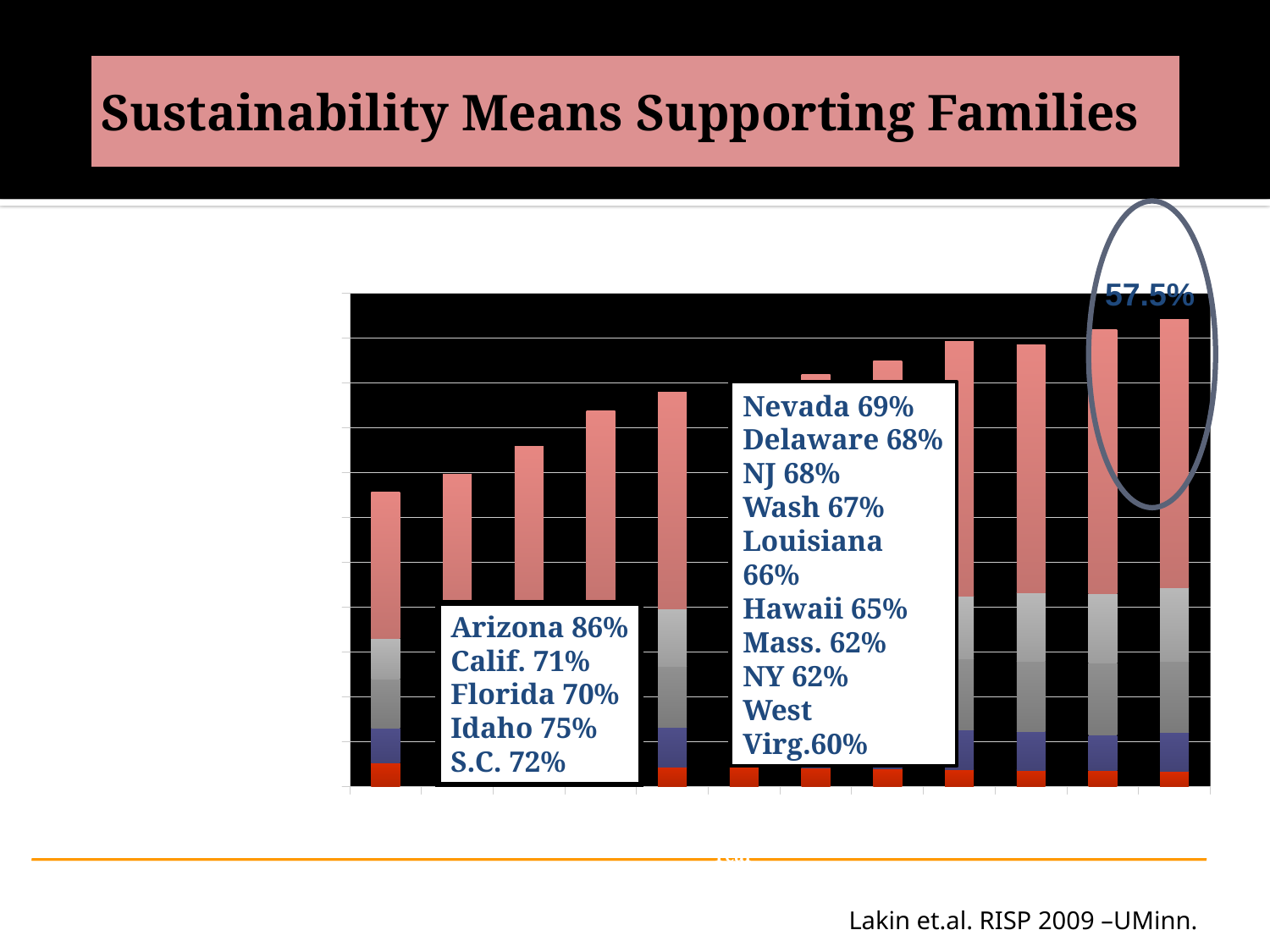
How many bars are plotted in the chart? 12 According to the text box on the chart, what percentage is listed for Arizona? 86% What is the title shown at the top of the slide? Sustainability Means Supporting Families What value is circled at the top right of the chart? 57.5% What kind of chart is shown on the slide? stacked bar chart According to the text box on the chart, what percentage is listed for West Virg.? 60% Which state has the higher percentage in the text boxes, Idaho or Calif.? Idaho Do the bar heights rise or fall from left to right across the chart? rise According to the text box on the chart, what percentage is listed for Nevada? 69% Which bar in the chart is the tallest? the rightmost bar Which bar in the chart is the shortest? the leftmost bar What is the difference between the percentages listed for Arizona and Florida in the text box? 16%